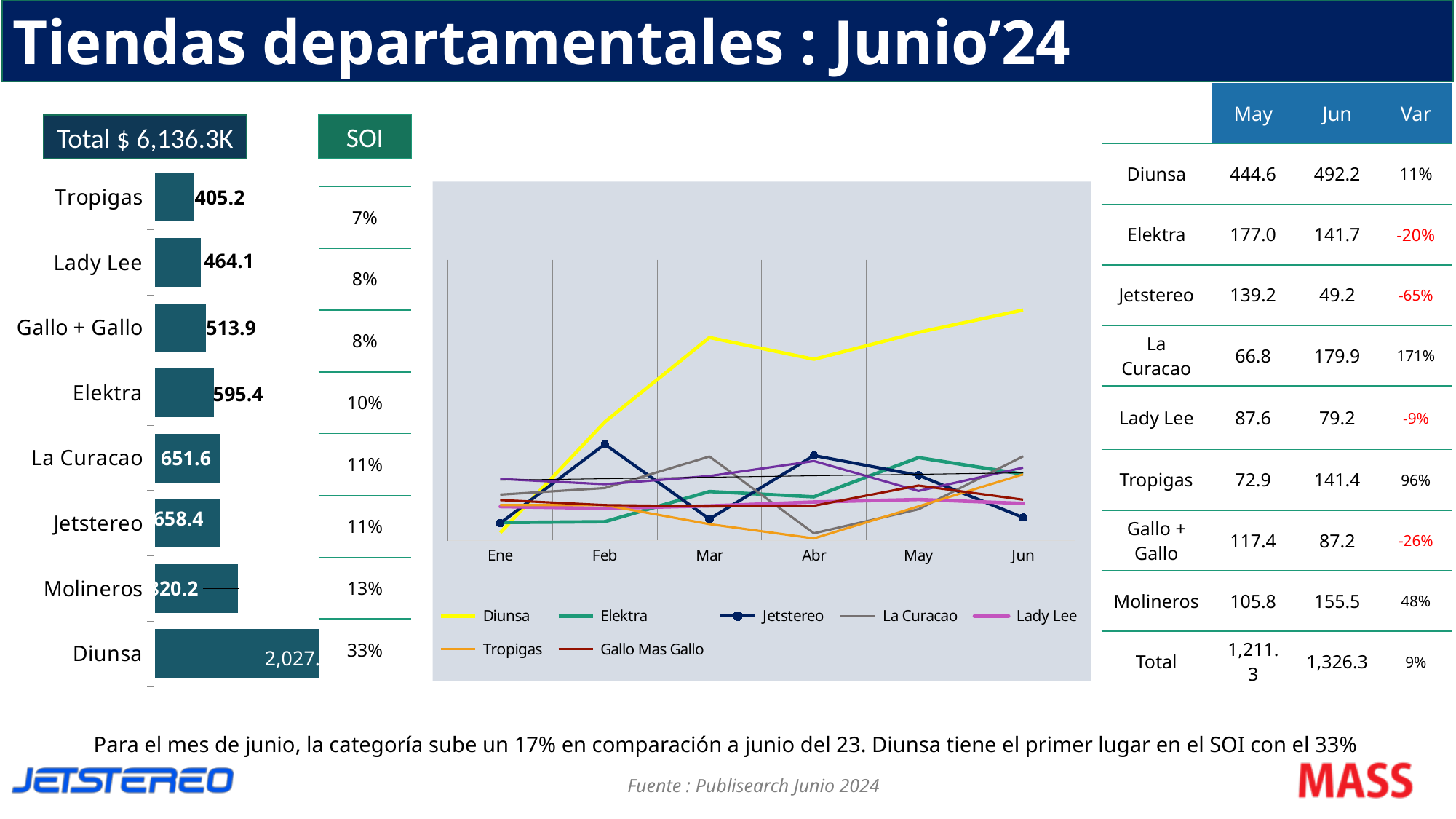
How many series does the legend of the line chart in the middle list? 7 In the bar chart on the left, what is the difference between the values for Elektra and Lady Lee? 131.3 What kind of chart is the chart in the middle of the slide? Line chart In the bar chart on the left, which store has the highest value? Diunsa In the bar chart on the left, what is the value for Elektra? 595.4 In the bar chart on the left, what is the value for La Curacao? 651.6 In the bar chart on the left, what is the difference between the values for Jetstereo and La Curacao? 6.8 In the bar chart on the left, which store has the lowest value? Tropigas In the line chart in the middle, which series is highest in Jun? Diunsa How many stores are shown in the bar chart on the left? 8 In the bar chart on the left, which is larger: the value for Gallo + Gallo or the value for Lady Lee? Gallo + Gallo In the bar chart on the left, what is the value for Tropigas? 405.2